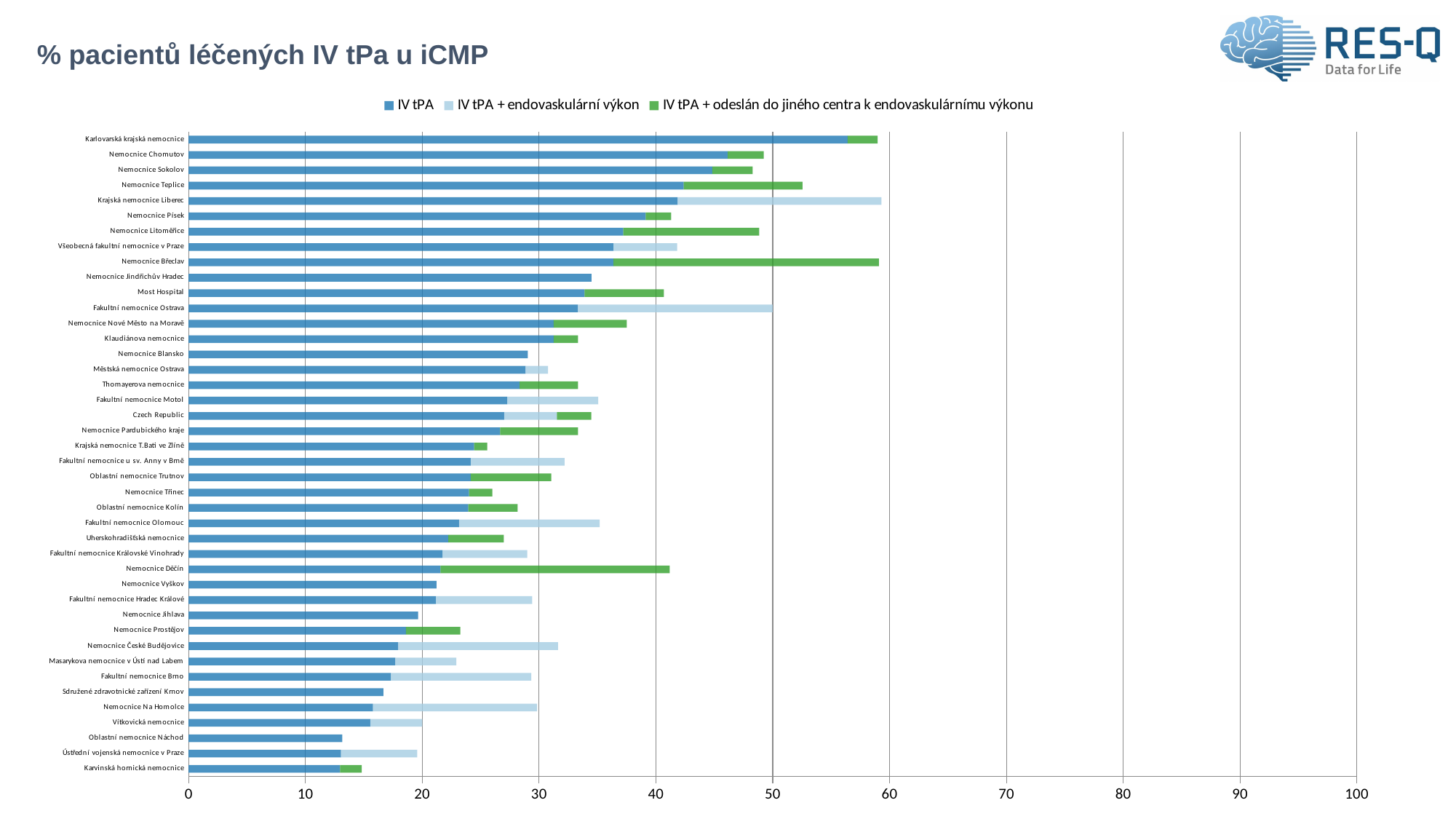
How many series does the legend list? 3 What is the title of the chart? % pacientů léčených IV tPa u iCMP Which has a larger IV tPA value, Karlovarská krajská nemocnice or Nemocnice Chomutov? Karlovarská krajská nemocnice Is the IV tPA value for Czech Republic greater or less than 30? less Is the IV tPA value for Karlovarská krajská nemocnice greater or less than 50? greater What kind of chart is shown on the slide? Bar chart Is the total bar length for Nemocnice Děčín greater or less than 30? greater How many hospitals (categories) are plotted on the chart? 42 Which hospital has the highest IV tPA value? Karlovarská krajská nemocnice Which series is shown in green in the legend? IV tPA + odeslán do jiného centra k endovaskulárnímu výkonu